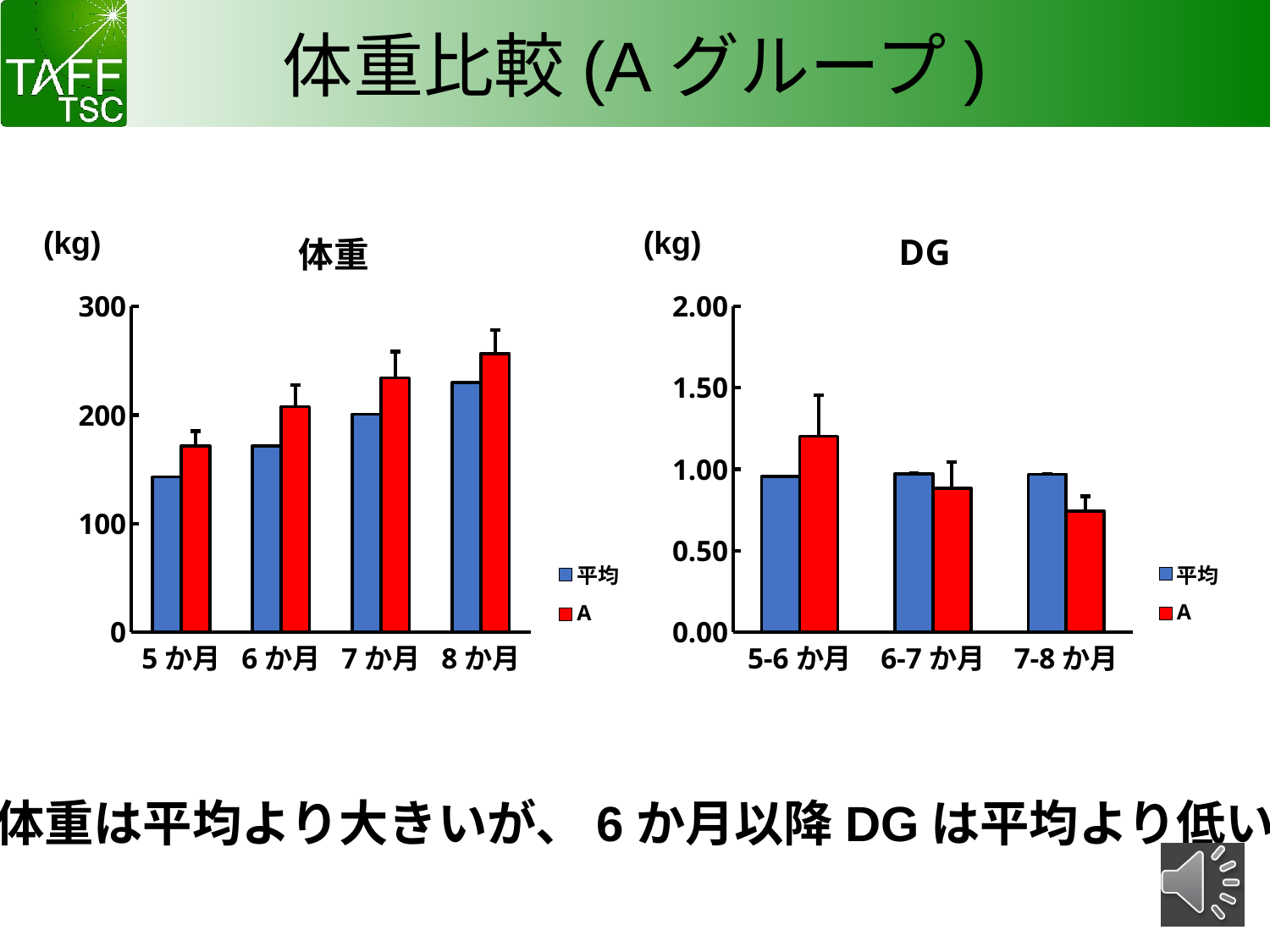
In the DG chart, which is larger at 7-8 か月, 平均 or A? 平均 In the DG chart, is the value for A at 7-8 か月 greater or less than 1.00? less In the DG chart, at which category is the A series lowest? 7-8 か月 In the 体重 chart, is the value for A at 8 か月 greater or less than 200? greater How many categories are shown on the x axis of the DG chart? 3 How many series does the legend of the DG chart list? 2 What kind of chart is the 体重 chart on the left? bar chart In the 体重 chart, at which category is the A series highest? 8 か月 In the DG chart, is the value for A at 5-6 か月 greater or less than 1.00? greater In the DG chart, do the values for A rise or fall from 5-6 か月 to 7-8 か月? fall How many categories are shown on the x axis of the 体重 chart? 4